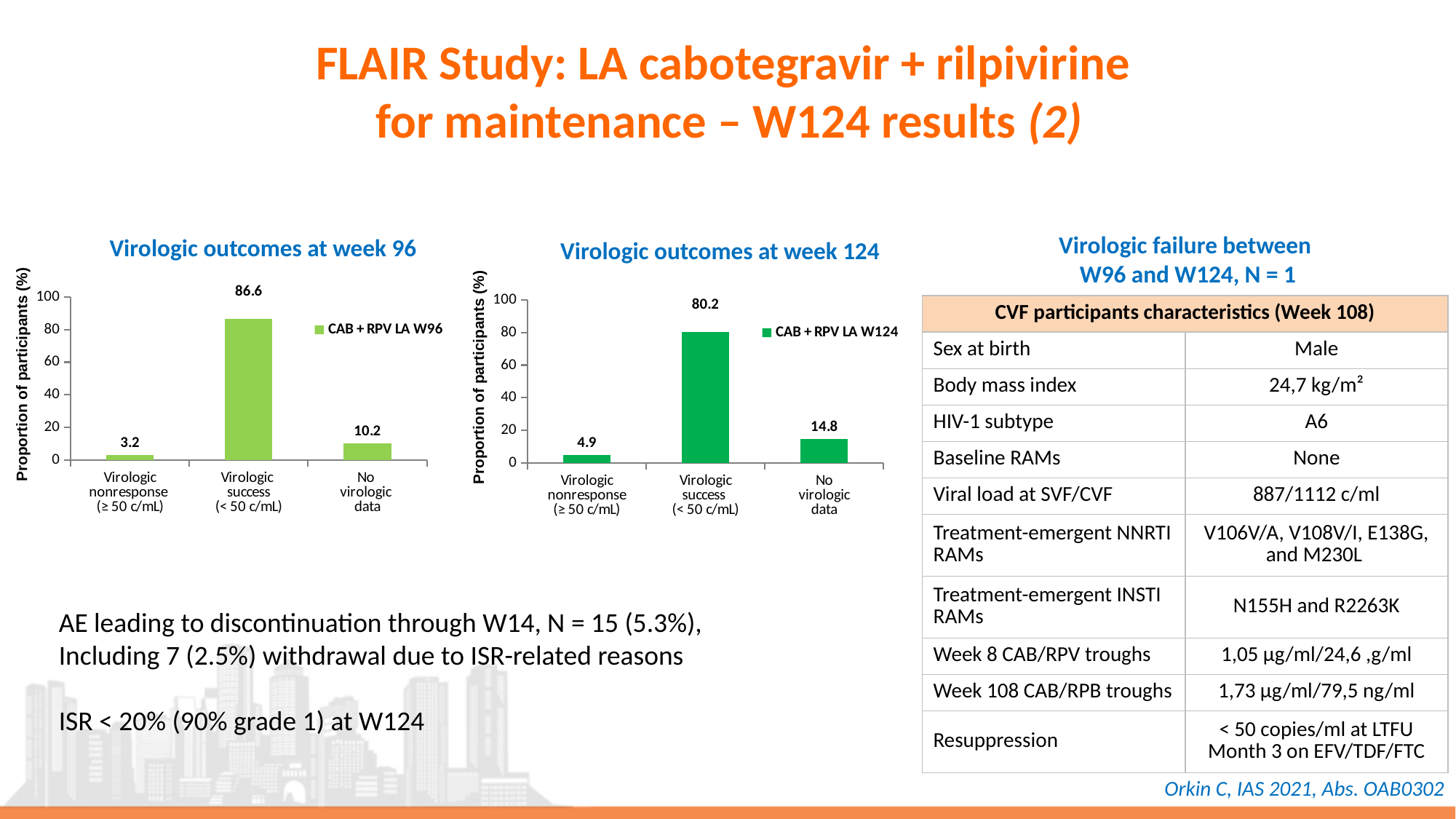
In the 'Virologic outcomes at week 124' chart, what is the value for No virologic data? 14.8 What type of chart is 'Virologic outcomes at week 124'? Bar chart In the 'Virologic outcomes at week 124' chart, which category has the highest value? Virologic success (< 50 c/mL) In the 'Virologic outcomes at week 96' chart, which is larger: No virologic data or Virologic nonresponse? No virologic data In the 'Virologic outcomes at week 96' chart, what is the value for Virologic success (< 50 c/mL)? 86.6 In the 'Virologic outcomes at week 124' chart, what is the value for Virologic nonresponse (≥ 50 c/mL)? 4.9 In the 'Virologic outcomes at week 124' chart, what is the difference between No virologic data and Virologic nonresponse? 9.9 What is the legend entry in the 'Virologic outcomes at week 124' chart? CAB + RPV LA W124 In the 'Virologic outcomes at week 124' chart, is the value for Virologic success greater or less than 60? greater How many categories are shown on the x axis of the 'Virologic outcomes at week 96' chart? 3 In the 'Virologic outcomes at week 96' chart, what is the difference between Virologic success and No virologic data? 76.4 In the 'Virologic outcomes at week 96' chart, which category has the lowest value? Virologic nonresponse (≥ 50 c/mL)